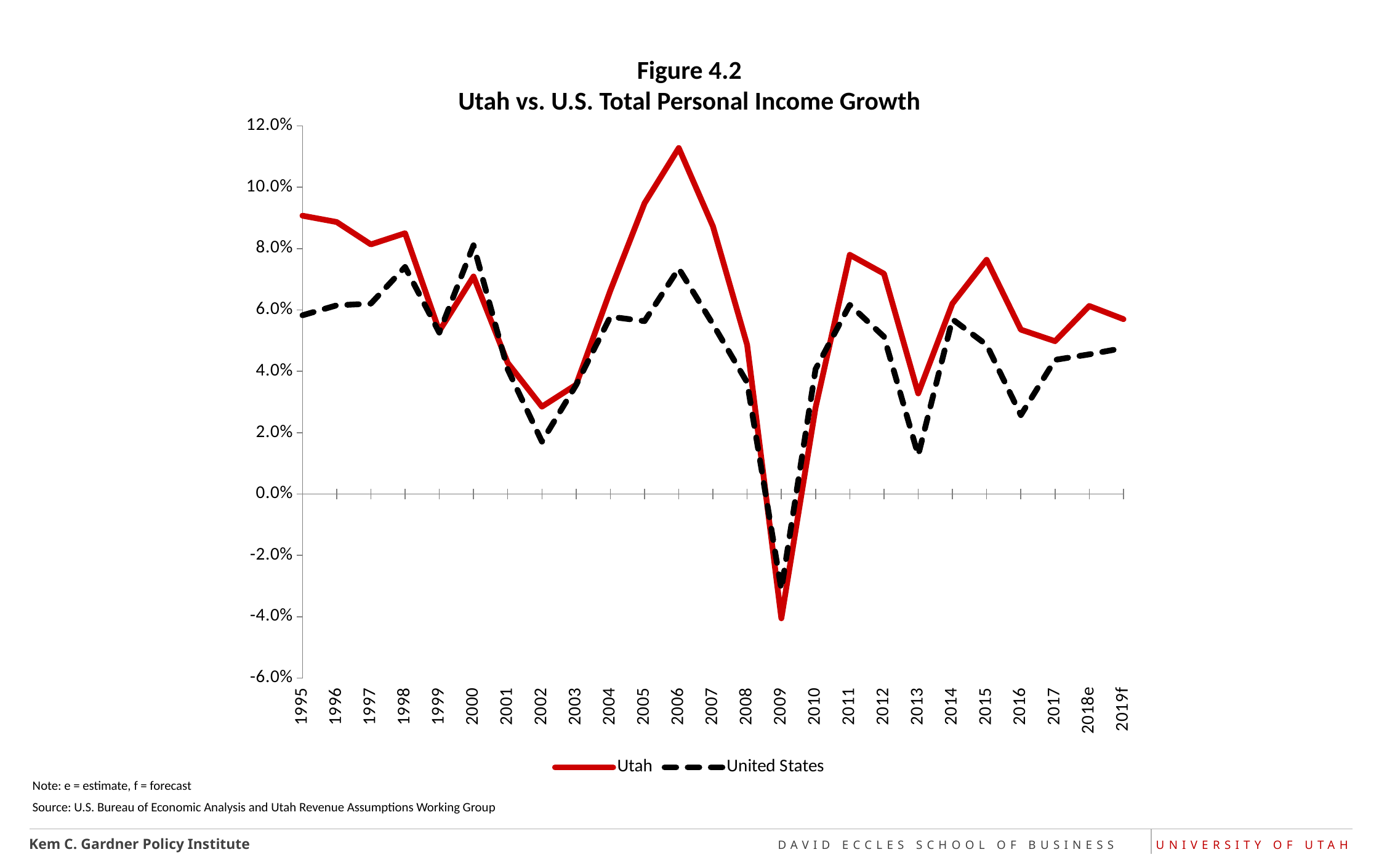
Is the United States value for 2013 greater or less than 2.0%? less How many years are shown along the x axis? 25 Is the Utah value for 2009 greater or less than -2.0%? less Which series has the larger value in 2013, Utah or United States? Utah How many series does the legend list? 2 Does the Utah series rise or fall from 2006 to 2009? Fall Is the Utah value for 2006 greater or less than 10.0%? greater In which year does the Utah series reach its lowest value? 2009 Which series has the larger value in 2000, Utah or United States? United States Which series is drawn with a dashed line? United States What kind of chart is shown on the slide? Line chart In which year does the Utah series reach its highest value? 2006